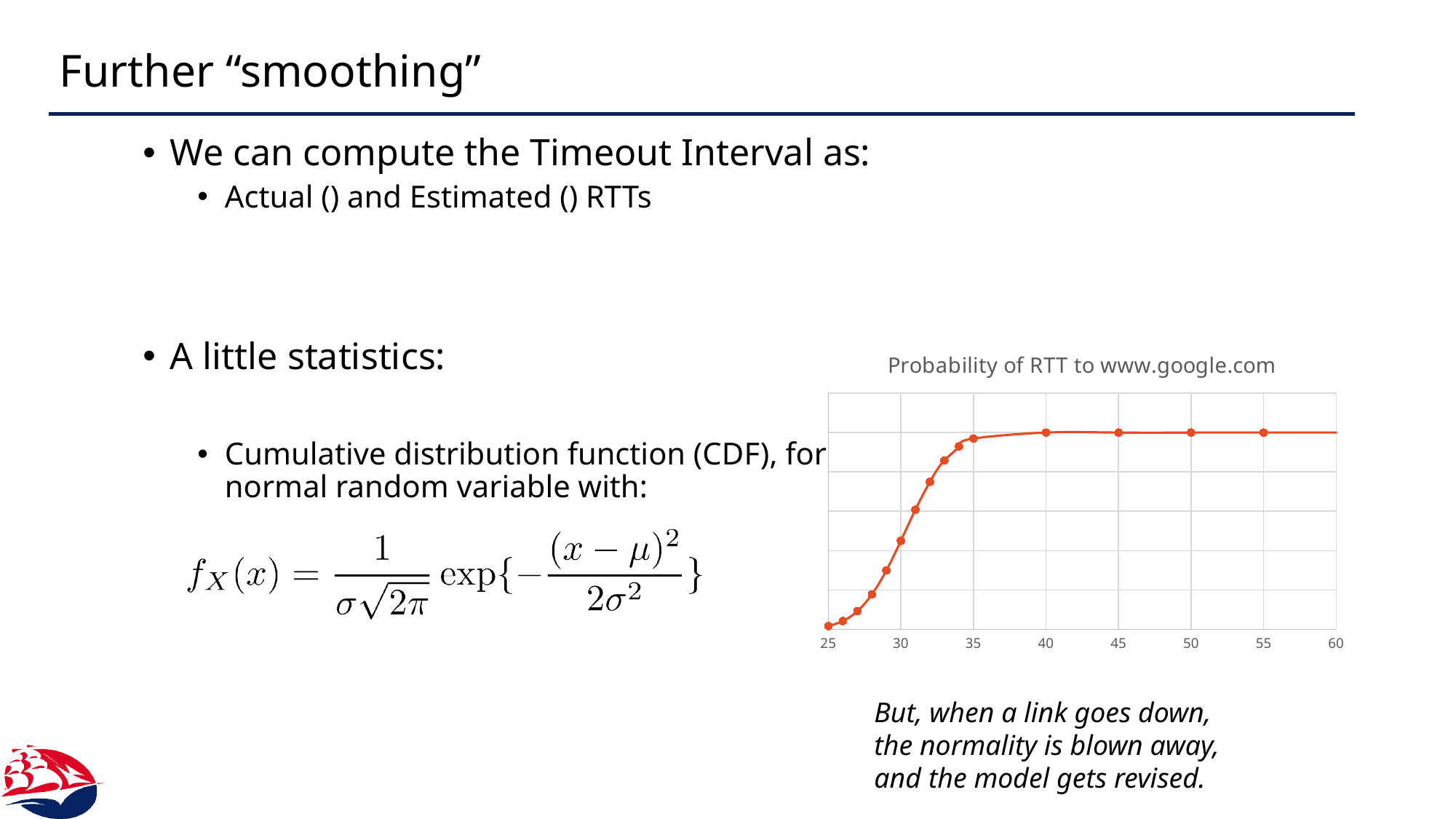
What is the lowest value labelled on the x axis? 25 Do the plotted values rise or fall as the x axis goes from 25 to 35? rise How many data points are marked on the line? 15 What is the highest value labelled on the x axis? 60 At which x-axis value is the plotted curve lowest? 25 Is the plotted value at x = 30 larger or smaller than the value at x = 40? smaller After about x = 40, does the curve keep rising or stay flat? stay flat Is the plotted value at x = 35 larger or smaller than the value at x = 25? larger What kind of chart is shown on the slide? line chart What is the title of the chart? Probability of RTT to www.google.com